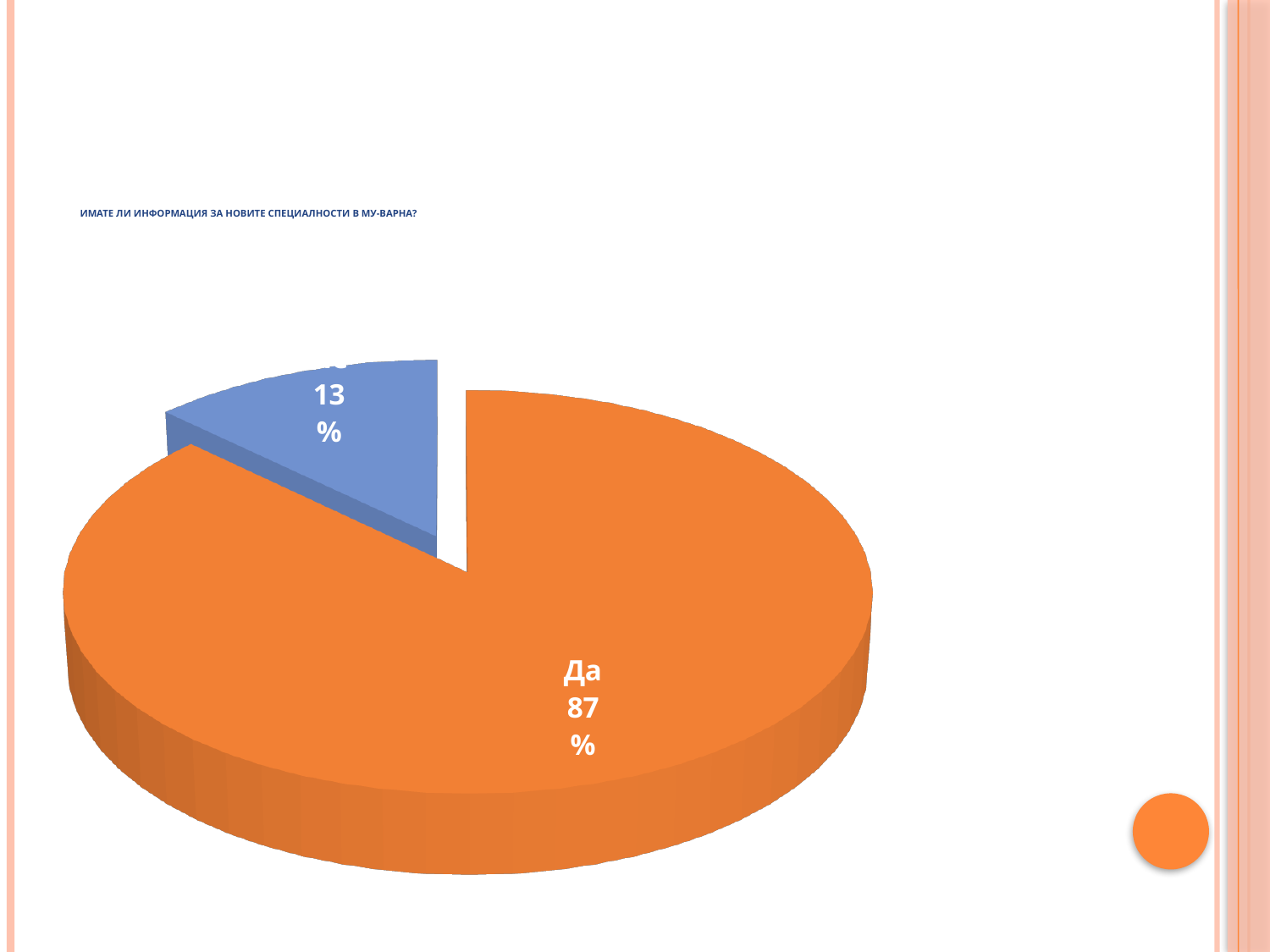
By how many percentage points does the "Да" slice exceed the blue slice? 74 percentage points What share of the pie does "Да" take? 87% What do the two slices of the pie add up to? 100% What percentage is shown for the "Да" slice? 87% How many slices does the pie chart have? 2 What colour is the "Да" slice? orange What is the title of the chart? ИМАТЕ ЛИ ИНФОРМАЦИЯ ЗА НОВИТЕ СПЕЦИАЛНОСТИ В МУ-ВАРНА? What is the value of the smallest slice of the pie? 13% Which is larger: the "Да" slice or the blue slice? Да What percentage is shown on the blue slice of the pie? 13% What kind of chart is shown on the slide? pie chart Which slice of the pie is the largest? Да